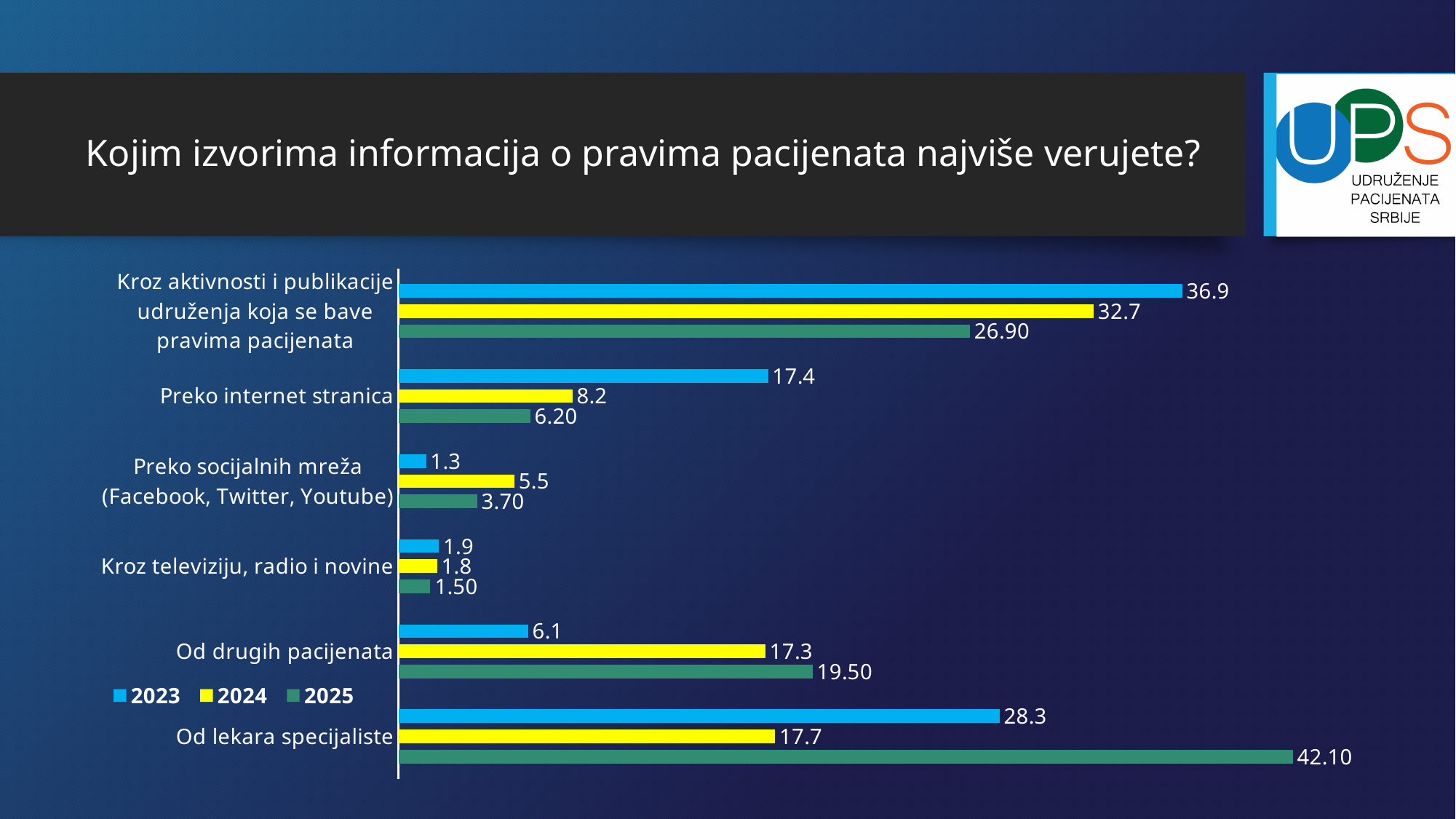
What kind of chart is shown on the slide? Bar chart What is the 2023 value for "Preko internet stranica"? 17.4 Which is larger for "Od lekara specijaliste": the 2023 value or the 2024 value? 2023 How many categories are shown on the chart? 6 Which category has the lowest 2025 value? Kroz televiziju, radio i novine What is the 2025 value for "Od lekara specijaliste"? 42.10 What is the 2024 value for "Od drugih pacijenata"? 17.3 What is the difference between the 2025 and 2024 values for "Od lekara specijaliste"? 24.4 How many series does the legend list? 3 Which category has the highest 2023 value? Kroz aktivnosti i publikacije udruženja koja se bave pravima pacijenata What is the difference between the 2023 and 2024 values for "Kroz aktivnosti i publikacije udruženja koja se bave pravima pacijenata"? 4.2 Which series is shown in yellow? 2024